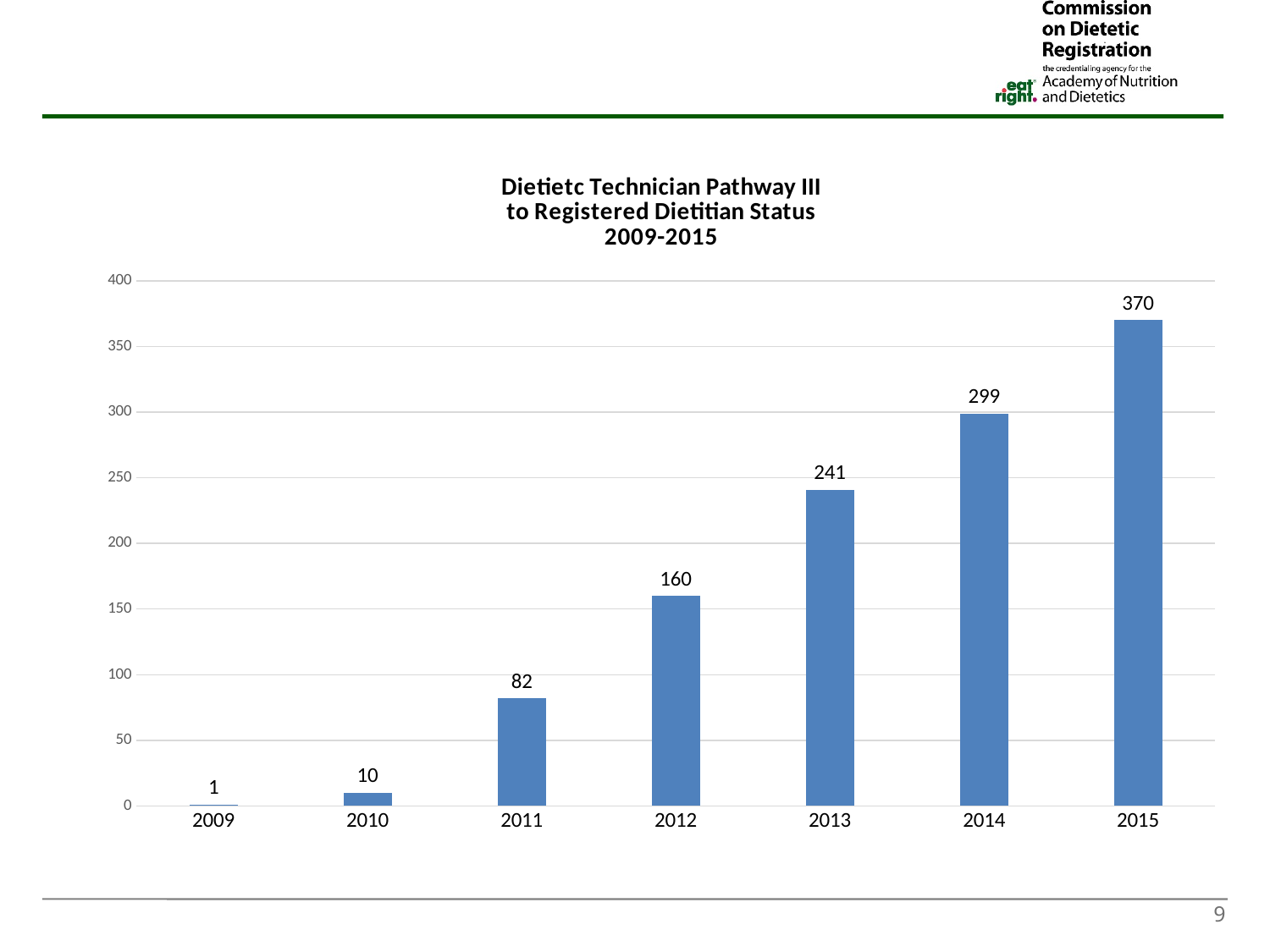
How many years are shown on the x axis? 7 Do the values rise or fall from 2009 to 2015? rise Which year has the lowest value? 2009 What kind of chart is shown on the slide? bar chart Which is larger, the value for 2012 or the value for 2013? 2013 What is the value for 2013? 241 What is the difference between the values for 2012 and 2011? 78 What is the value for 2010? 10 Is the value for 2014 greater or less than 250? greater What is the value for 2015? 370 Which year has the highest value? 2015 What is the difference between the values for 2015 and 2014? 71